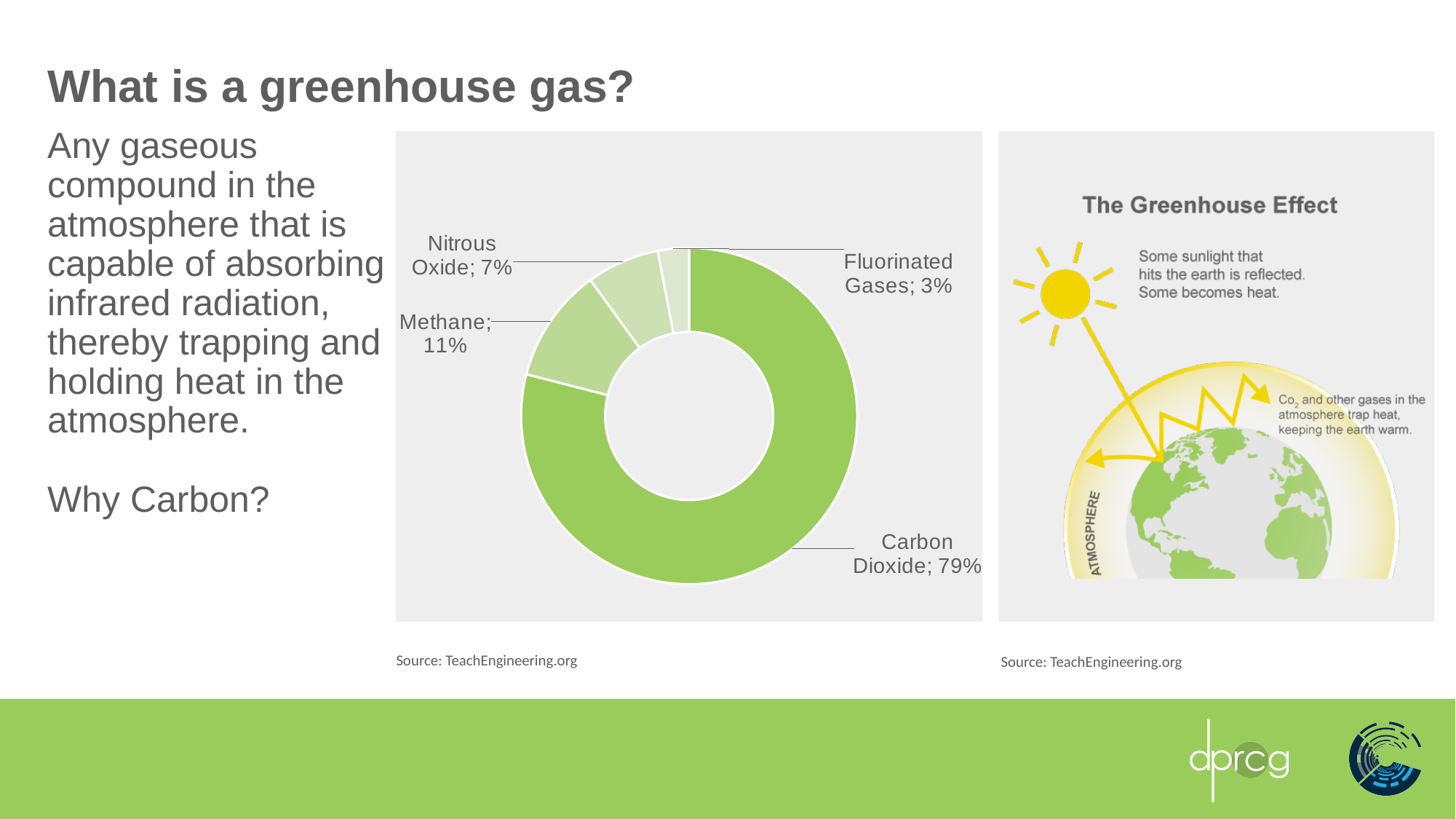
Which has a larger share in the doughnut chart, Methane or Nitrous Oxide? Methane Which gas has the smallest slice in the doughnut chart? Fluorinated Gases What is the difference in percentage points between Methane and Nitrous Oxide in the doughnut chart? 4 What type of chart is used to show the greenhouse gas shares? Doughnut chart What percentage is shown for Fluorinated Gases in the doughnut chart? 3% How many gas categories are shown in the doughnut chart? 4 What percentage is shown for Methane in the doughnut chart? 11% What is the combined share of Methane, Nitrous Oxide and Fluorinated Gases in the doughnut chart? 21% What is the difference in percentage points between Carbon Dioxide and Methane in the doughnut chart? 68 What percentage is shown for Nitrous Oxide in the doughnut chart? 7% What share of the doughnut chart does Carbon Dioxide represent? 79% Which gas has the largest slice in the doughnut chart? Carbon Dioxide